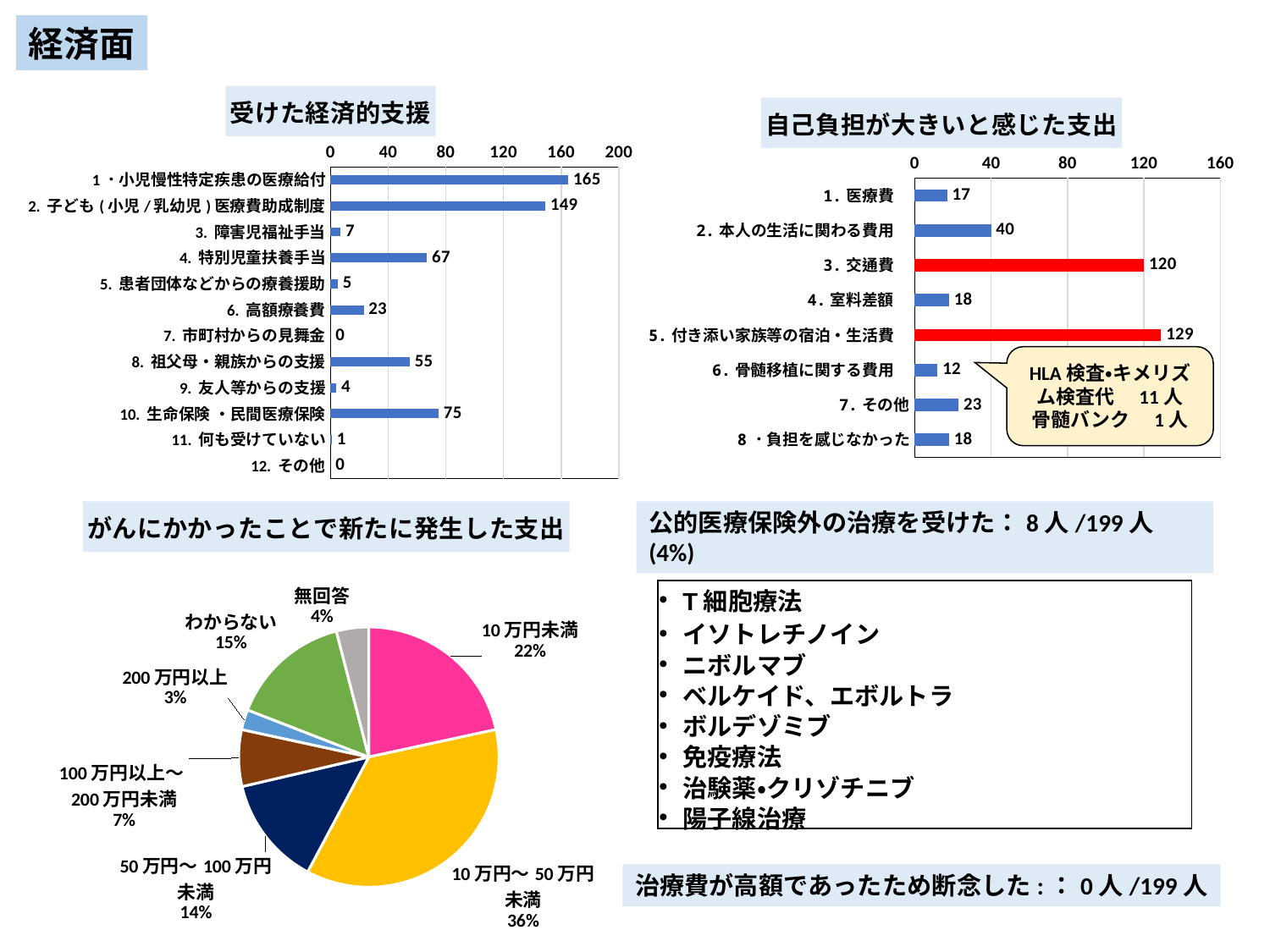
In the chart titled 受けた経済的支援, what is the difference between the values for 10. 生命保険・民間医療保険 and 4. 特別児童扶養手当? 8 In the chart titled 自己負担が大きいと感じた支出, what is the value for 3. 交通費? 120 In the chart titled 自己負担が大きいと感じた支出, what is the difference between the values for 5. 付き添い家族等の宿泊・生活費 and 3. 交通費? 9 In the pie chart titled がんにかかったことで新たに発生した支出, what share does 10万円～50万円未満 have? 36% In the chart titled 自己負担が大きいと感じた支出, which category has the highest value? 5. 付き添い家族等の宿泊・生活費 In the chart titled 自己負担が大きいと感じた支出, which category has the lowest value? 6. 骨髄移植に関する費用 In the chart titled 受けた経済的支援, what is the value for 1・小児慢性特定疾患の医療給付? 165 In the chart titled 受けた経済的支援, which is larger, the value for 8. 祖父母・親族からの支援 or the value for 6. 高額療養費? 8. 祖父母・親族からの支援 In the chart titled 自己負担が大きいと感じた支出, what colour are the bars for 3. 交通費 and 5. 付き添い家族等の宿泊・生活費? Red In the chart titled 受けた経済的支援, which category has the highest value? 1・小児慢性特定疾患の医療給付 In the chart titled 受けた経済的支援, how many categories are plotted? 12 What kind of chart is the one titled がんにかかったことで新たに発生した支出? Pie chart